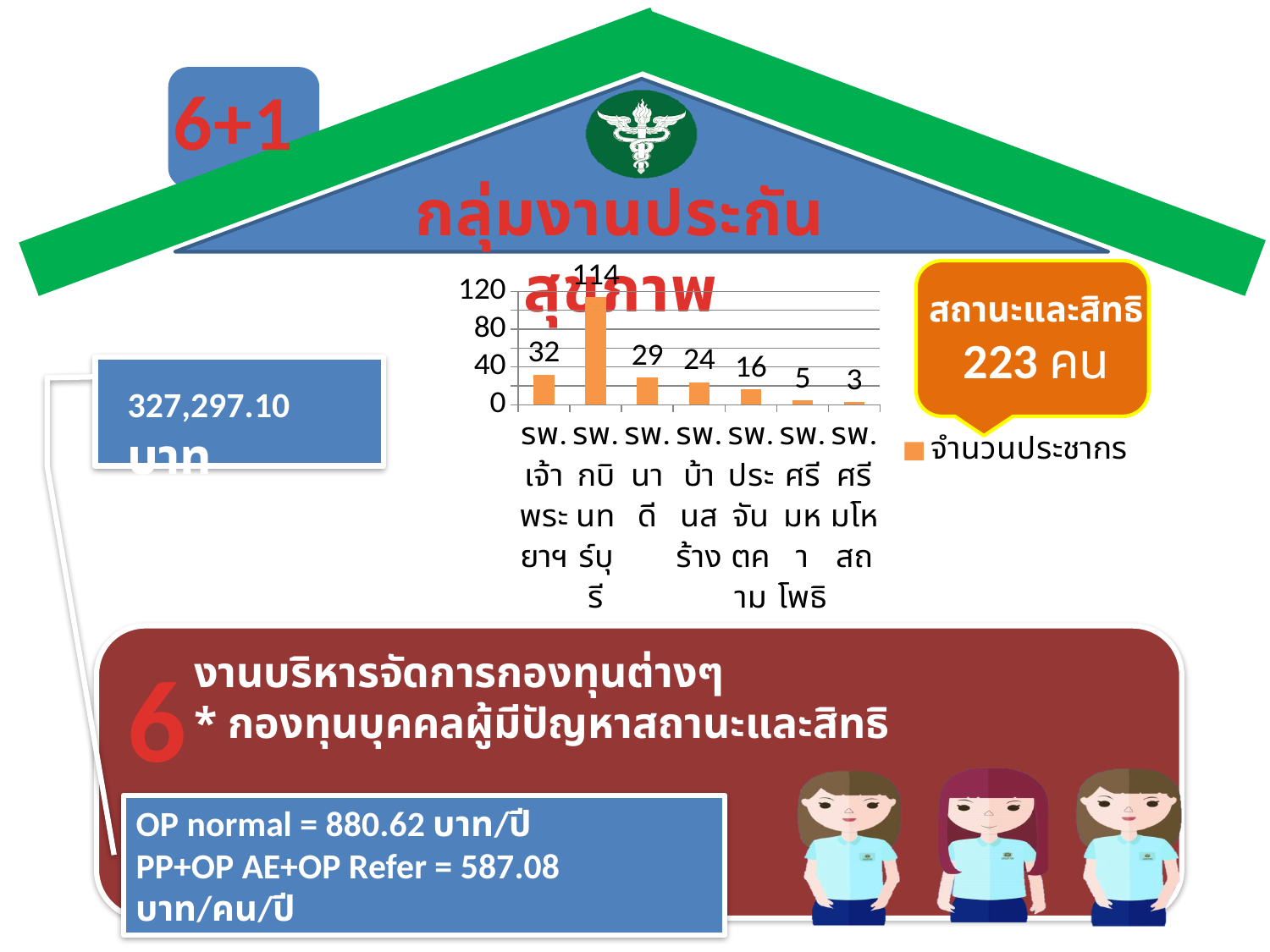
Which category has the lowest value in the bar chart? รพ.ศรีมโหสถ How many series does the chart legend list? 1 What is the value for รพ.กบินทร์บุรี in the bar chart? 114 What is the value for รพ.เจ้าพระยาฯ in the bar chart? 32 How many categories are shown in the bar chart? 7 Which is larger, the value for รพ.นาดี or the value for รพ.บ้านสร้าง? รพ.นาดี What is the value for รพ.ประจันตคาม in the bar chart? 16 What is the difference between the values for รพ.กบินทร์บุรี and รพ.เจ้าพระยาฯ? 82 What kind of chart is shown on the slide? bar chart Is the value for รพ.กบินทร์บุรี greater or less than 80? greater Which category has the highest value in the bar chart? รพ.กบินทร์บุรี What is the name of the series shown in the chart legend? จำนวนประชากร